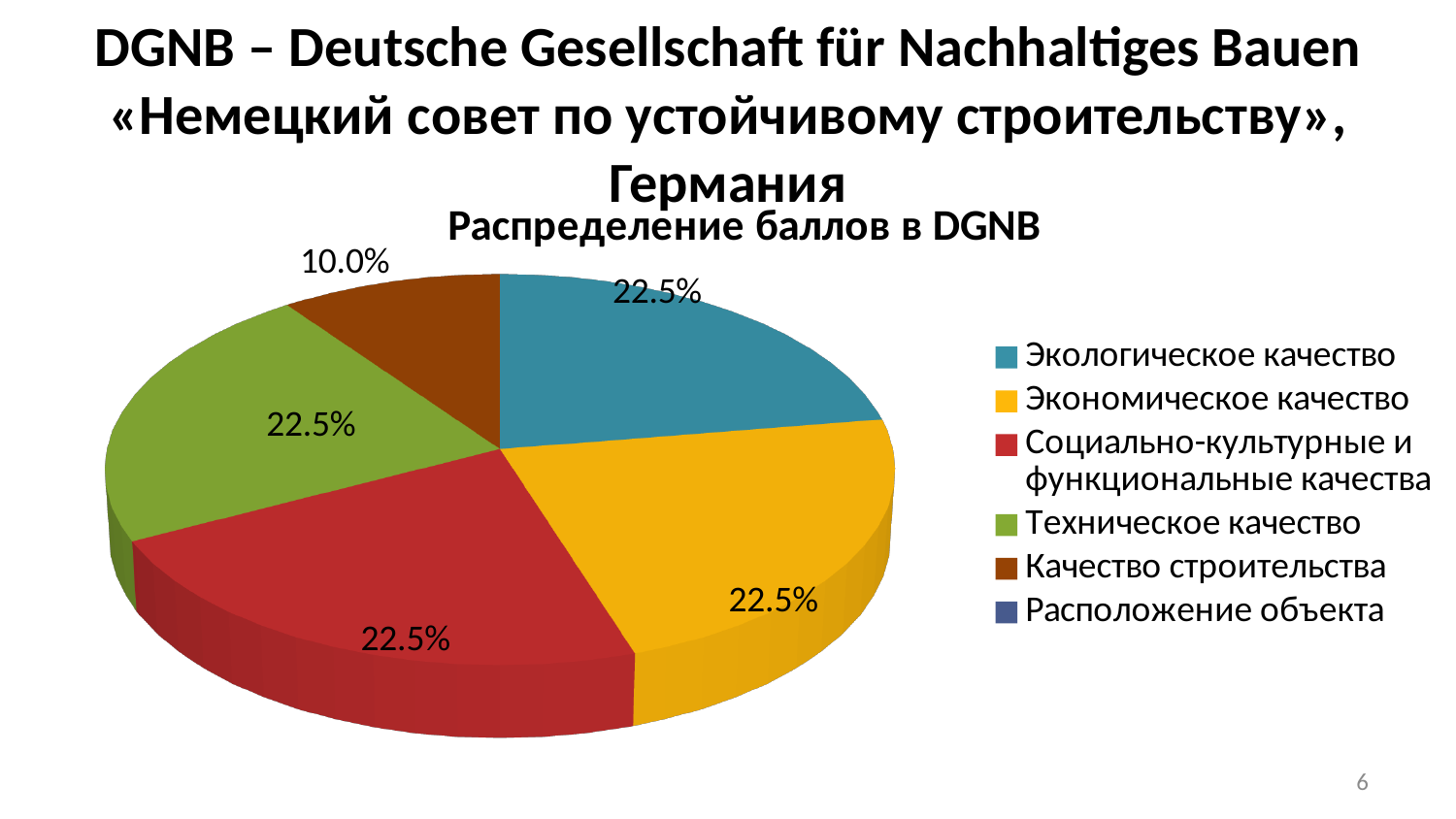
Which is larger, the share for Экологическое качество or the share for Качество строительства? Экологическое качество What is the difference in percentage points between the share for Техническое качество and the share for Качество строительства? 12.5 What share of the pie does Экологическое качество have? 22.5% What is the value shown for Социально-культурные и функциональные качества? 22.5% How many categories does the legend list? 6 What share of the pie does Качество строительства have? 10.0% What colour is the slice for Техническое качество? Green What kind of chart is shown on the slide? Pie chart What share of the pie does Техническое качество have? 22.5% What is the title of the chart? Распределение баллов в DGNB Which category has a share of 10.0%? Качество строительства